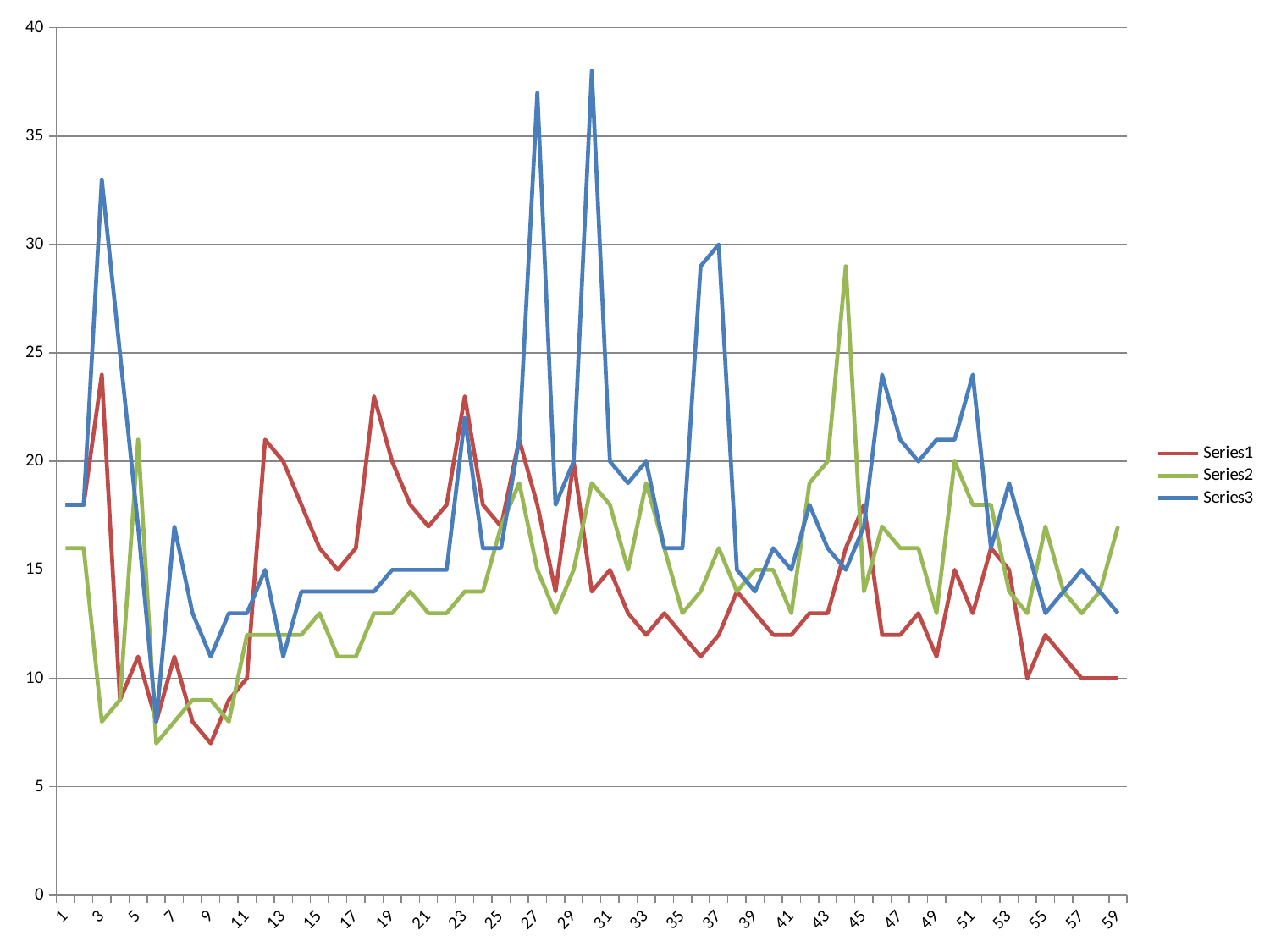
What kind of chart is shown on the slide? line chart Is the value for Series3 at x = 30 greater or less than 35? greater How many series does the legend list? 3 What are the legend entries on the chart? Series1, Series2, Series3 Is the value for Series2 at x = 6 greater or less than 10? less Is the value for Series2 at x = 44 greater or less than 25? greater At x = 44, which is larger: Series2 or Series3? Series2 Which series reaches the highest value anywhere on the chart? Series3 At x = 3, which is larger: Series3 or Series1? Series3 What colour is the line for Series3? blue